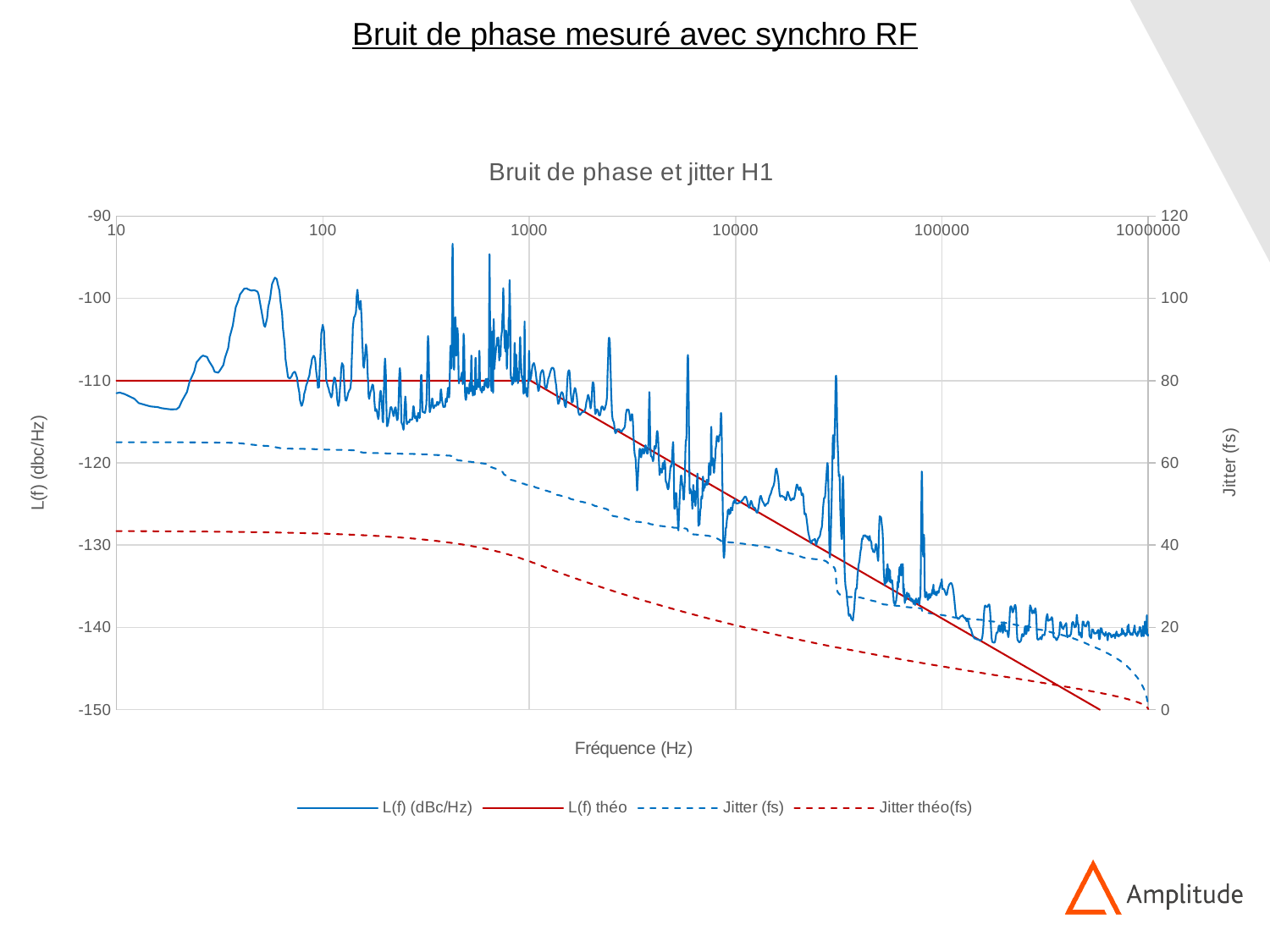
Is the value of Jitter (fs) at 10 Hz greater or less than 60? greater Is the value of L(f) théo at 100000 Hz greater or less than -130? less What is the label of the x axis? Fréquence (Hz) At 10 Hz, which is larger: Jitter (fs) or Jitter théo(fs)? Jitter (fs) What kind of chart is shown on the slide? line chart Does the Jitter (fs) series rise or fall along the x axis overall? fall What is the value of the Jitter théo(fs) series at 1000000 Hz? 0 How many series does the legend list? 4 What is the title of the chart? Bruit de phase et jitter H1 Is the value of Jitter théo(fs) at 10 Hz greater or less than 60? less Does the L(f) théo series rise or fall as frequency increases from 1000 Hz to 1000000 Hz? fall What is the value of the L(f) théo series at 10 Hz? -110